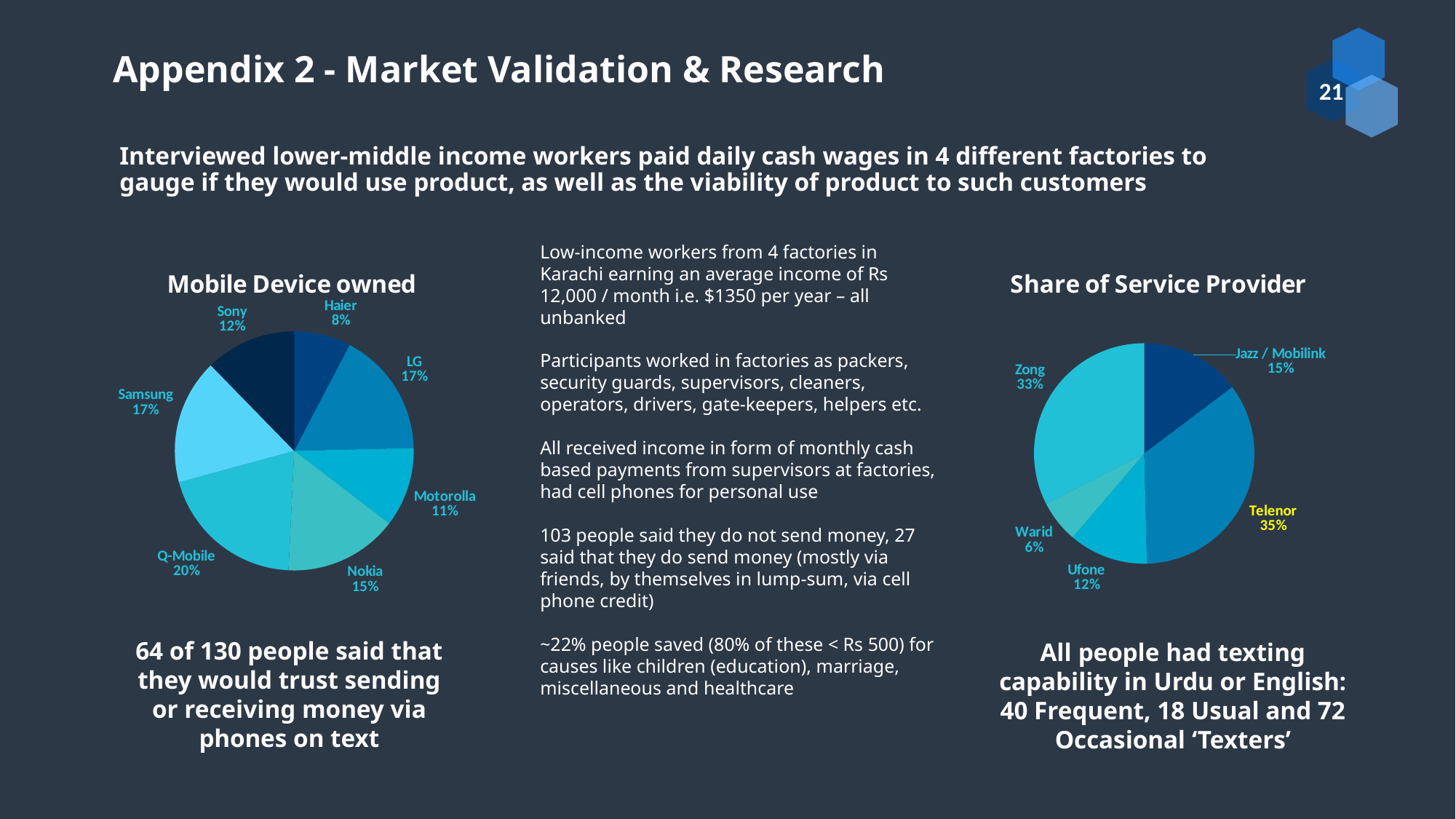
In the 'Share of Service Provider' chart, what share does Telenor have? 35% In the 'Share of Service Provider' chart, how many service providers are shown? 5 In the 'Share of Service Provider' chart, what share does Warid have? 6% In the 'Share of Service Provider' chart, which provider has the smallest share? Warid In the 'Share of Service Provider' chart, which is larger, Ufone or Jazz / Mobilink? Jazz / Mobilink In the 'Mobile Device owned' chart, which device brand has the largest share? Q-Mobile What type of chart is the 'Share of Service Provider' chart? Pie chart In the 'Mobile Device owned' chart, what is the difference between the Q-Mobile share and the Nokia share? 5% In the 'Mobile Device owned' chart, what share is Haier? 8% In the 'Mobile Device owned' chart, what share is Q-Mobile? 20% In the 'Mobile Device owned' chart, which device brand has the smallest share? Haier In the 'Mobile Device owned' chart, how many device brands are shown? 7